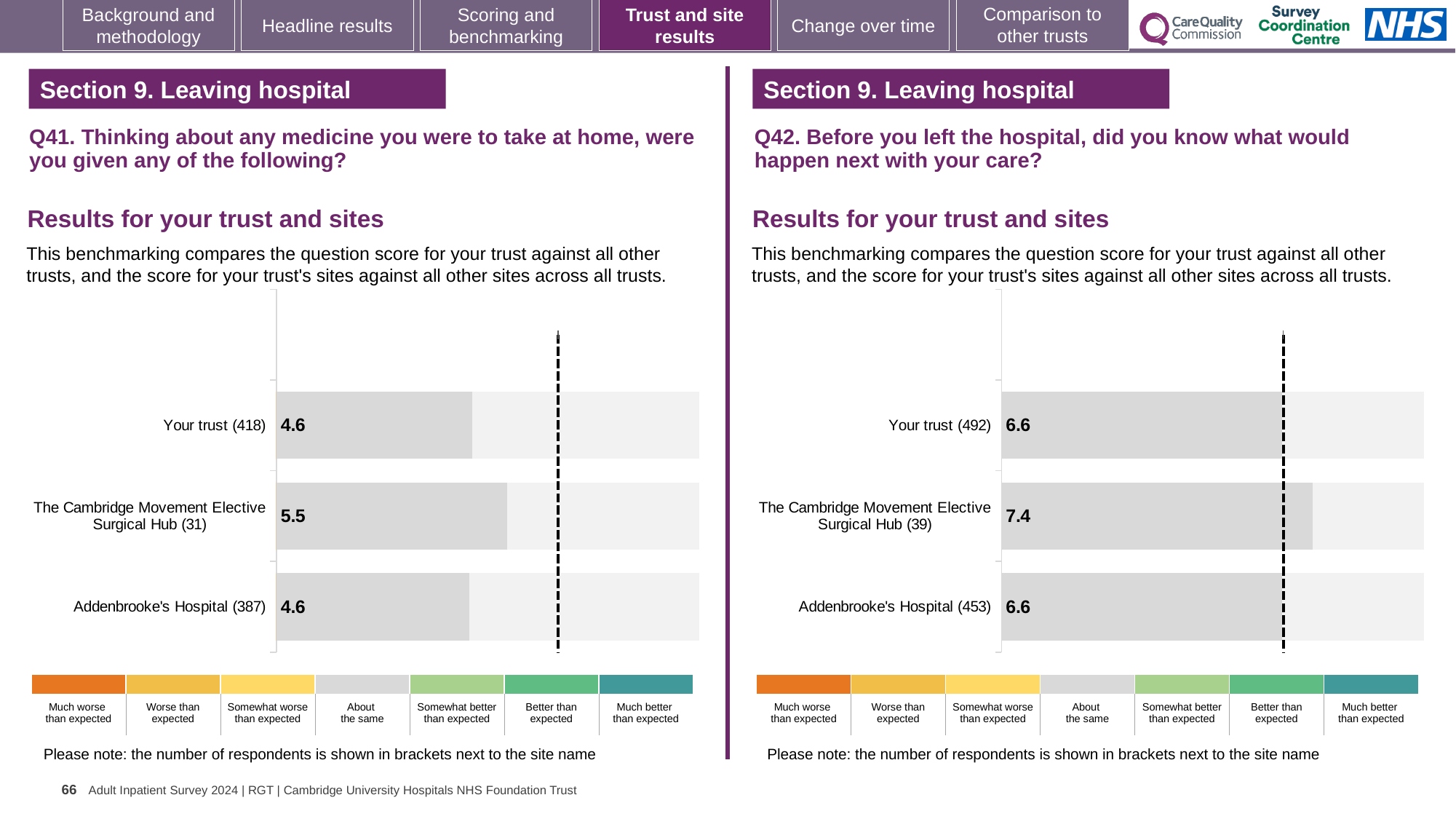
In the Q42 chart on the right, which site or trust has the highest score? The Cambridge Movement Elective Surgical Hub (39) In the Q42 chart on the right, what is the score for The Cambridge Movement Elective Surgical Hub (39)? 7.4 What type of chart is used for the Q41 results on the left? Bar chart In the Q41 chart on the left, what is the score for Your trust (418)? 4.6 In the Q41 chart on the left, how many bars are plotted? 3 In the Q41 chart on the left, what is the score for The Cambridge Movement Elective Surgical Hub (31)? 5.5 In the Q42 chart on the right, what is the score for Your trust (492)? 6.6 In the Q41 chart on the left, which site or trust has the highest score? The Cambridge Movement Elective Surgical Hub (31) In the Q41 chart on the left, what is the difference between the score for The Cambridge Movement Elective Surgical Hub (31) and the score for Addenbrooke's Hospital (387)? 0.9 In the Q42 chart on the right, what is the score for Addenbrooke's Hospital (453)? 6.6 How many categories does the colour key below the Q42 chart on the right list? 7 In the Q42 chart on the right, what is the difference between the score for The Cambridge Movement Elective Surgical Hub (39) and the score for Your trust (492)? 0.8